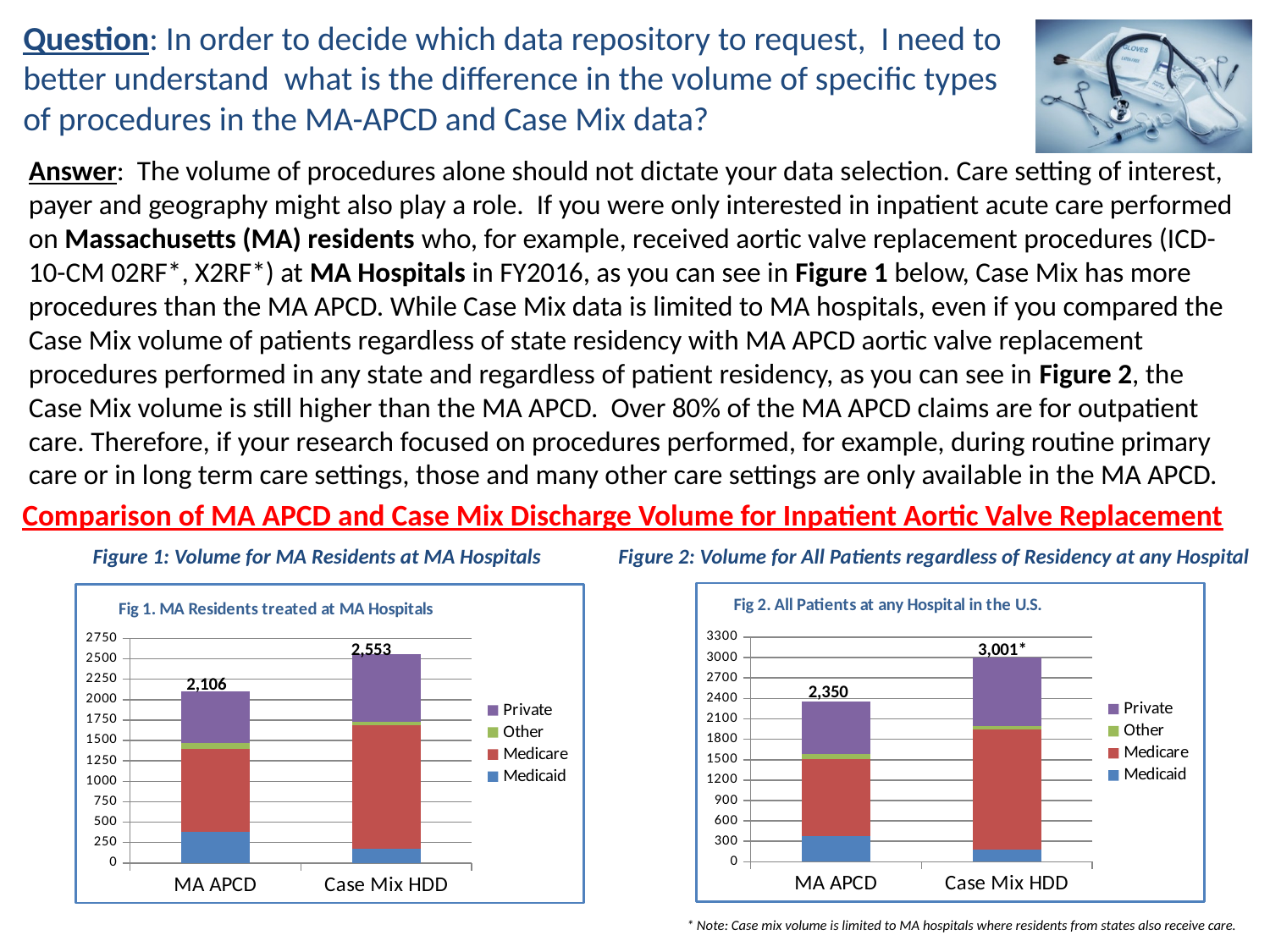
In Fig 2 (All Patients at any Hospital in the U.S.), what is the total volume labelled for the Case Mix HDD bar? 3,001* In Fig 2 (All Patients at any Hospital in the U.S.), what is the difference between the Case Mix HDD total and the MA APCD total? 651 In Fig 1 (MA Residents treated at MA Hospitals), what is the total volume labelled for the MA APCD bar? 2,106 What kind of chart is Fig 1 (MA Residents treated at MA Hospitals)? Stacked bar chart In Fig 1 (MA Residents treated at MA Hospitals), what is the difference between the Case Mix HDD total and the MA APCD total? 447 In Fig 2 (All Patients at any Hospital in the U.S.), which data source has the lower total volume? MA APCD In Fig 2 (All Patients at any Hospital in the U.S.), is the Medicaid value for Case Mix HDD greater or less than 300? less In Fig 1 (MA Residents treated at MA Hospitals), is the Medicaid value for MA APCD greater or less than 500? less In Fig 1 (MA Residents treated at MA Hospitals), what is the total volume labelled for the Case Mix HDD bar? 2,553 In Fig 2 (All Patients at any Hospital in the U.S.), what is the total volume labelled for the MA APCD bar? 2,350 How many series does the legend of Fig 2 (All Patients at any Hospital in the U.S.) list? 4 In Fig 1 (MA Residents treated at MA Hospitals), which data source has the higher total volume? Case Mix HDD